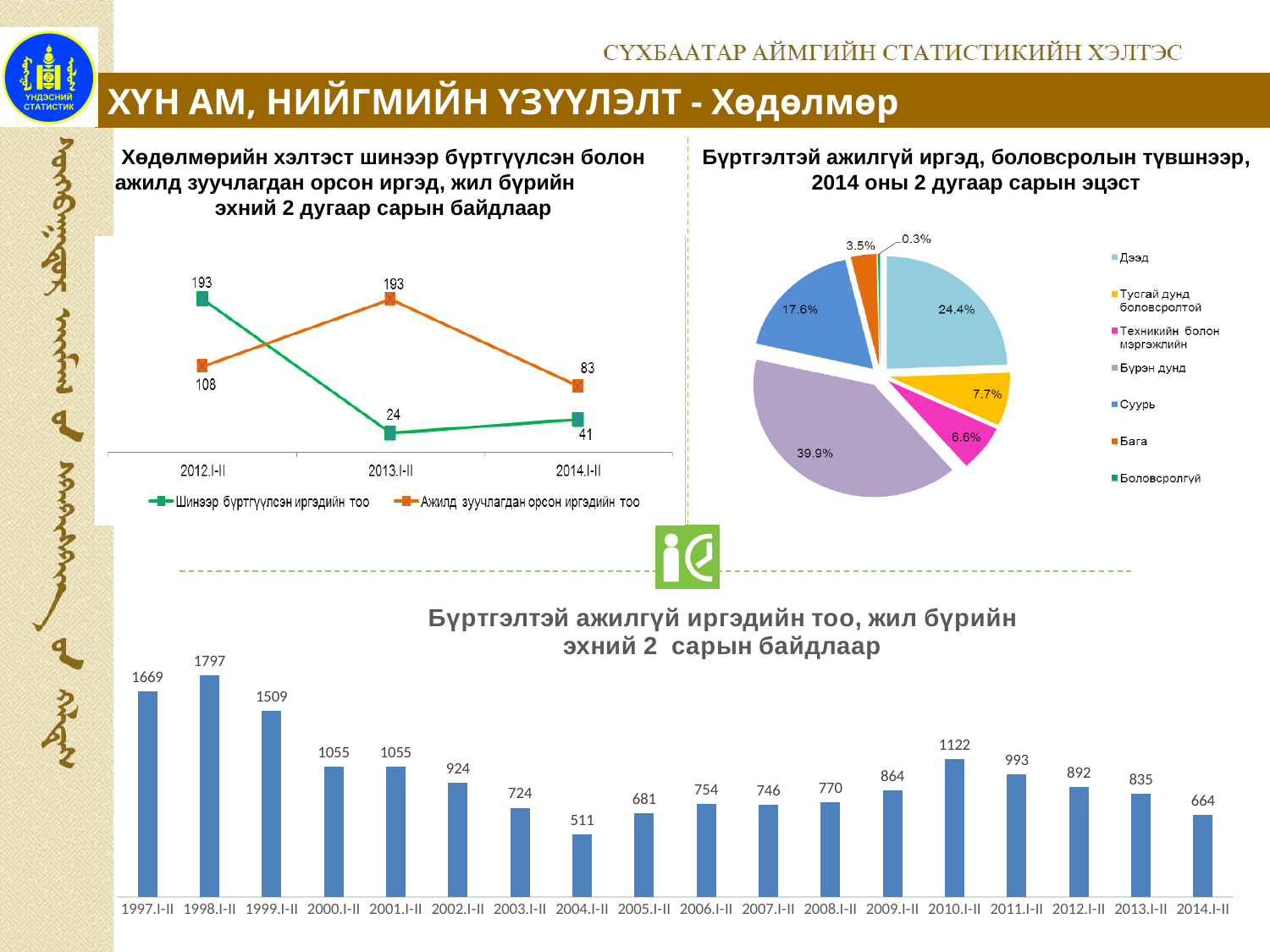
In the top-left line chart, what is the value of Ажилд зуучлагдан орсон иргэдийн тоо for 2014.I-II? 83 In the top-right pie chart (Бүртгэлтэй ажилгүй иргэд, боловсролын түвшнээр), what share does Бүрэн дунд have? 39.9% In the bottom bar chart (Бүртгэлтэй ажилгүй иргэдийн тоо), what is the value for 2010.I-II? 1122 In the bottom bar chart (Бүртгэлтэй ажилгүй иргэдийн тоо), what is the difference between the values for 2013.I-II and 2014.I-II? 171 In the top-left line chart, how many series does the legend list? 2 In the bottom bar chart (Бүртгэлтэй ажилгүй иргэдийн тоо), how many years are shown on the x axis? 18 What kind of chart is the bottom chart (Бүртгэлтэй ажилгүй иргэдийн тоо)? Bar chart In the bottom bar chart (Бүртгэлтэй ажилгүй иргэдийн тоо), which year has the lowest value? 2004.I-II In the bottom bar chart (Бүртгэлтэй ажилгүй иргэдийн тоо), which is larger: the value for 2011.I-II or 2012.I-II? 2011.I-II In the top-right pie chart (Бүртгэлтэй ажилгүй иргэд, боловсролын түвшнээр), which category has the smallest share? Боловсролгүй In the top-left line chart, what is the value of Шинээр бүртгүүлсэн иргэдийн тоо for 2013.I-II? 24 In the bottom bar chart (Бүртгэлтэй ажилгүй иргэдийн тоо), which year has the highest value? 1998.I-II